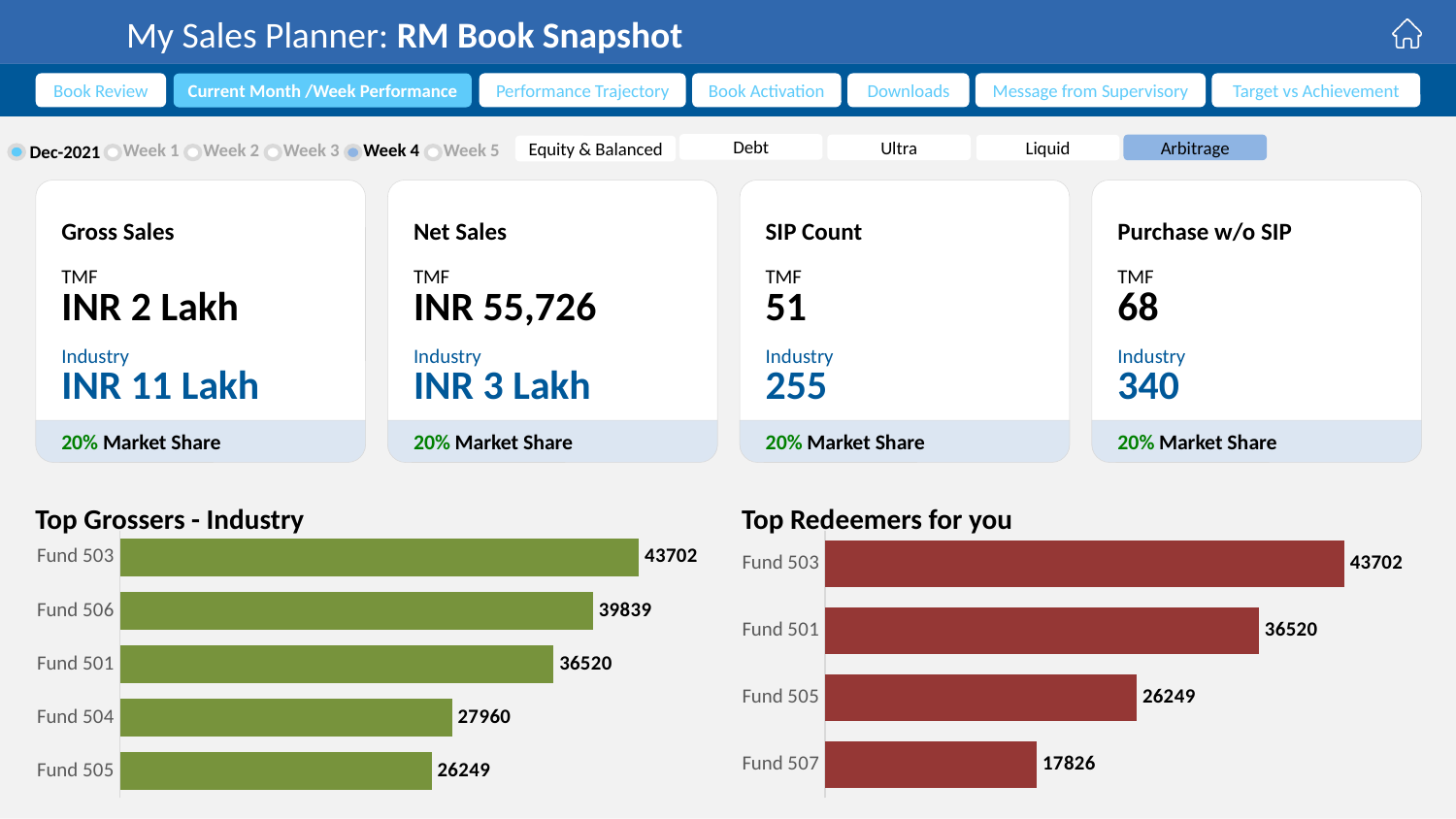
In the 'Top Grossers - Industry' chart, which is larger, the value for Fund 501 or Fund 504? Fund 501 In the 'Top Redeemers for you' chart, which fund has the lowest value? Fund 507 In the 'Top Grossers - Industry' chart, what is the value for Fund 506? 39839 In the 'Top Grossers - Industry' chart, what is the difference between the values for Fund 503 and Fund 506? 3863 In the 'Top Grossers - Industry' chart, which fund has the lowest value? Fund 505 In the 'Top Redeemers for you' chart, what is the value for Fund 505? 26249 In the 'Top Redeemers for you' chart, what is the value for Fund 507? 17826 How many funds are shown in the 'Top Redeemers for you' chart? 4 In the 'Top Grossers - Industry' chart, which fund has the highest value? Fund 503 In the 'Top Redeemers for you' chart, what is the difference between the values for Fund 501 and Fund 505? 10271 What type of chart is 'Top Grossers - Industry'? Bar chart In the 'Top Grossers - Industry' chart, what is the value for Fund 504? 27960